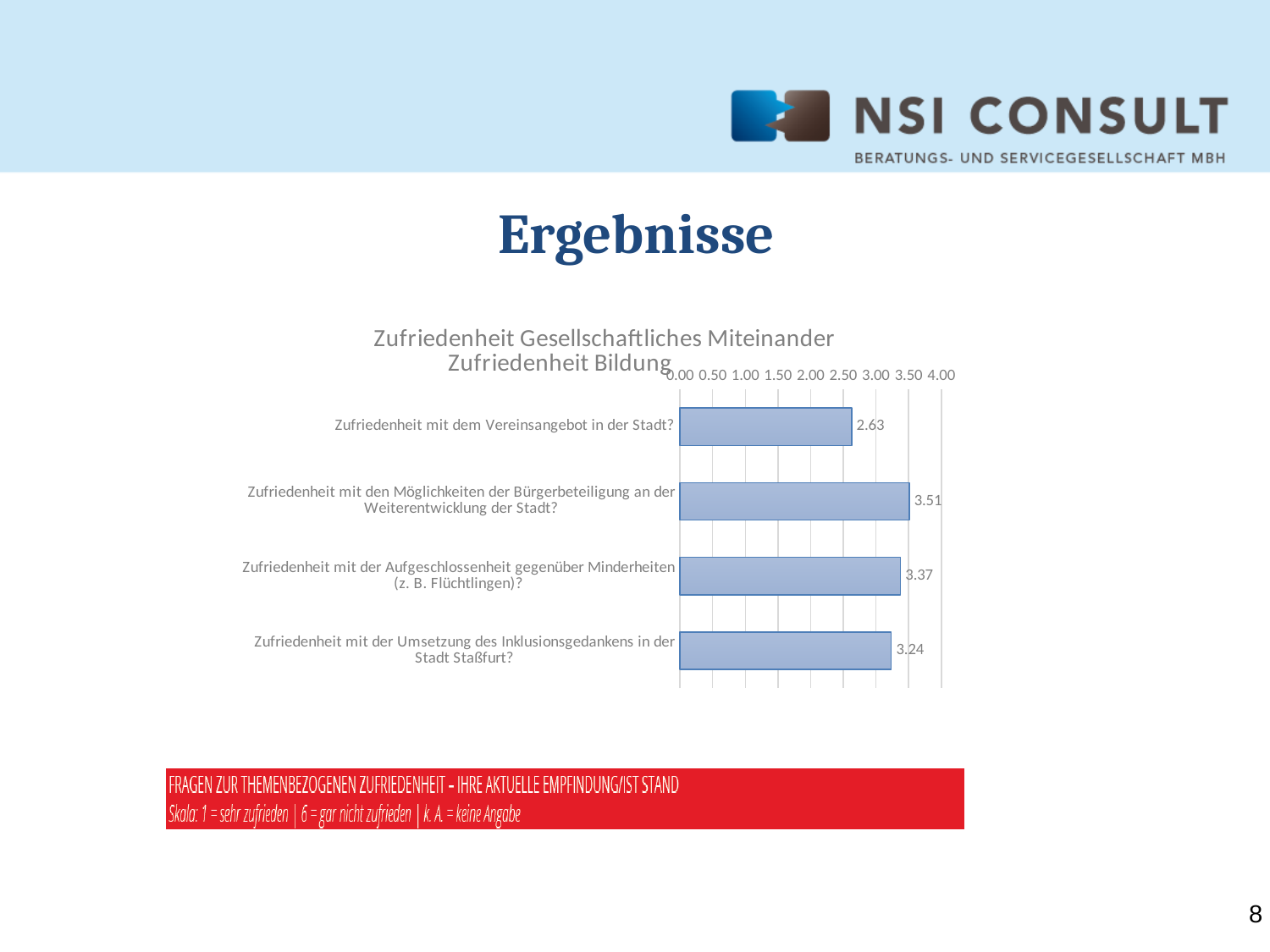
What is the value for "Zufriedenheit mit der Aufgeschlossenheit gegenüber Minderheiten (z. B. Flüchtlingen)?"? 3.37 Which category has the lowest value? Zufriedenheit mit dem Vereinsangebot in der Stadt? Which is larger: the value for Aufgeschlossenheit gegenüber Minderheiten or the value for Umsetzung des Inklusionsgedankens? Aufgeschlossenheit gegenüber Minderheiten What is the value for "Zufriedenheit mit den Möglichkeiten der Bürgerbeteiligung an der Weiterentwicklung der Stadt?"? 3.51 How many categories are shown in the chart? 4 What is the value for "Zufriedenheit mit der Umsetzung des Inklusionsgedankens in der Stadt Staßfurt?"? 3.24 What is the maximum value shown on the chart's value axis? 4.00 Is the value for "Zufriedenheit mit dem Vereinsangebot in der Stadt?" greater or less than 3.00? less Which category has the highest value? Zufriedenheit mit den Möglichkeiten der Bürgerbeteiligung an der Weiterentwicklung der Stadt? What kind of chart is shown on the slide? bar chart What is the value for "Zufriedenheit mit dem Vereinsangebot in der Stadt?"? 2.63 What is the difference between the value for Bürgerbeteiligung (3.51) and the value for Vereinsangebot (2.63)? 0.88